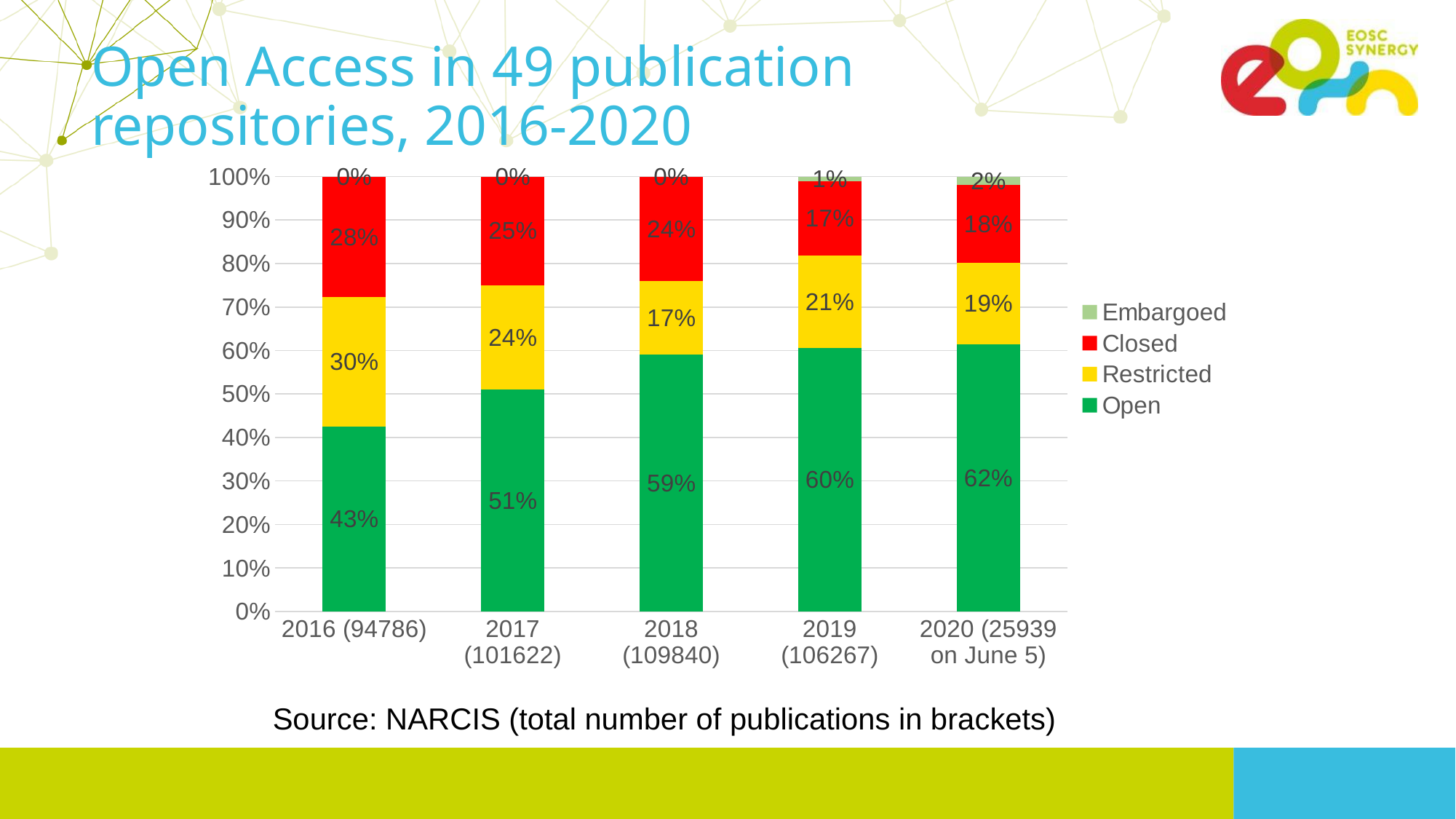
How many series does the legend list? 4 Does the Open share rise or fall from 2016 to 2020? Rise What is the Embargoed share for 2020? 2% What is the difference between the Open share in 2020 and in 2016? 19% Which year has the lowest Closed share? 2019 Which is larger in 2017, the Closed share or the Restricted share? Closed What is the Closed share for 2019? 17% How many years are shown on the x axis? 5 What is the Restricted share for 2018? 17% What kind of chart is shown? Stacked bar chart What is the Open share for 2016? 43% Which year has the highest Open share? 2020